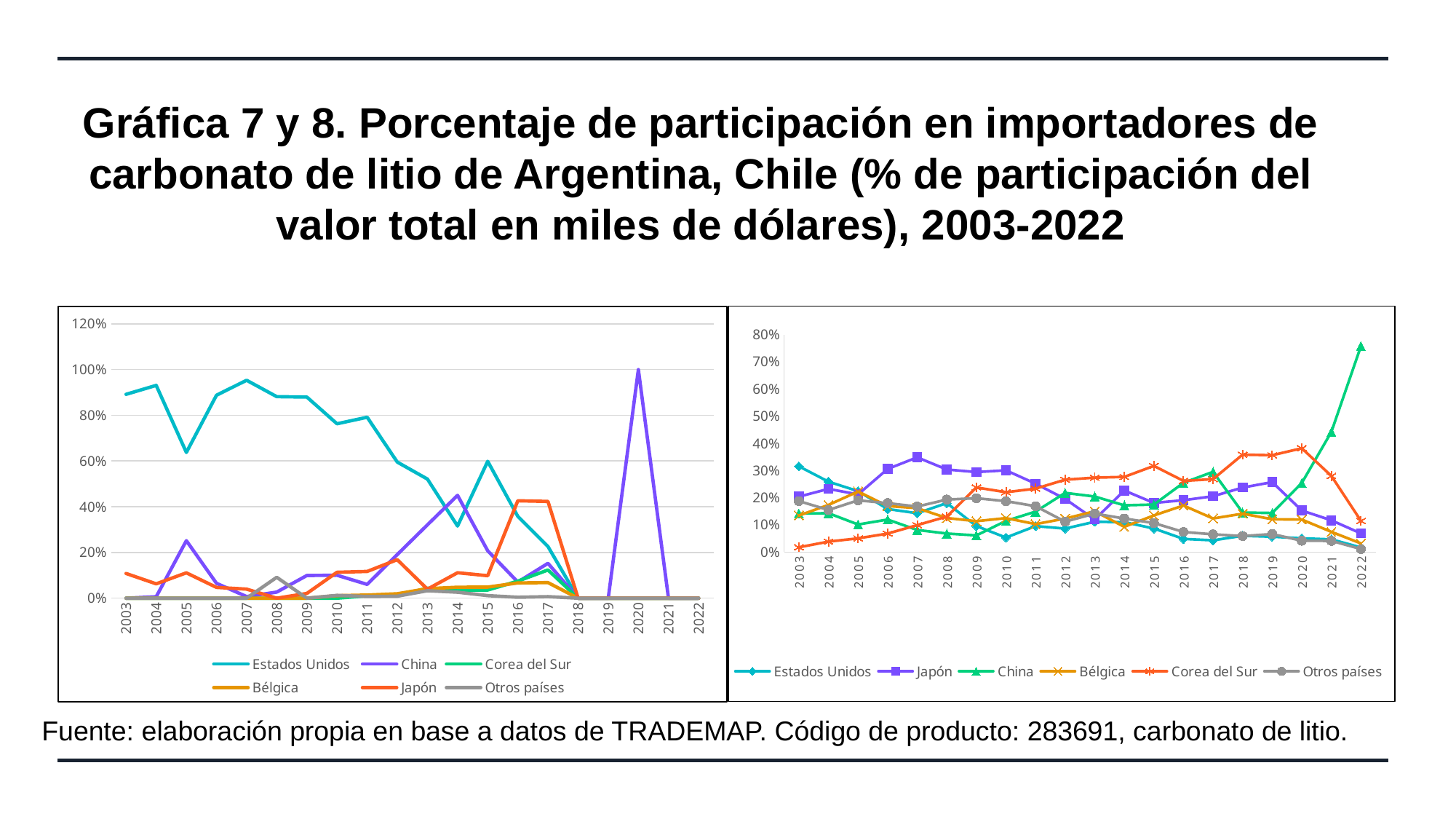
What kind of chart is the chart on the left side of the slide? line chart How many years are shown on the x axis of the right-hand chart? 20 How many series does the legend of the right-hand chart list? 6 In the left-hand chart, is the value for Estados Unidos in 2003 greater or less than 80%? greater In the left-hand chart, is the value for China in 2020 greater or less than 80%? greater How many series does the legend of the left-hand chart list? 6 In the right-hand chart, which series has the highest value in 2022? China In the right-hand chart, is the value for Corea del Sur in 2003 greater or less than 10%? less In the left-hand chart, which series has the highest value in 2003? Estados Unidos In the left-hand chart, does the Estados Unidos series rise or fall from 2007 to 2018? fall In the right-hand chart, does the China series rise or fall from 2019 to 2022? rise